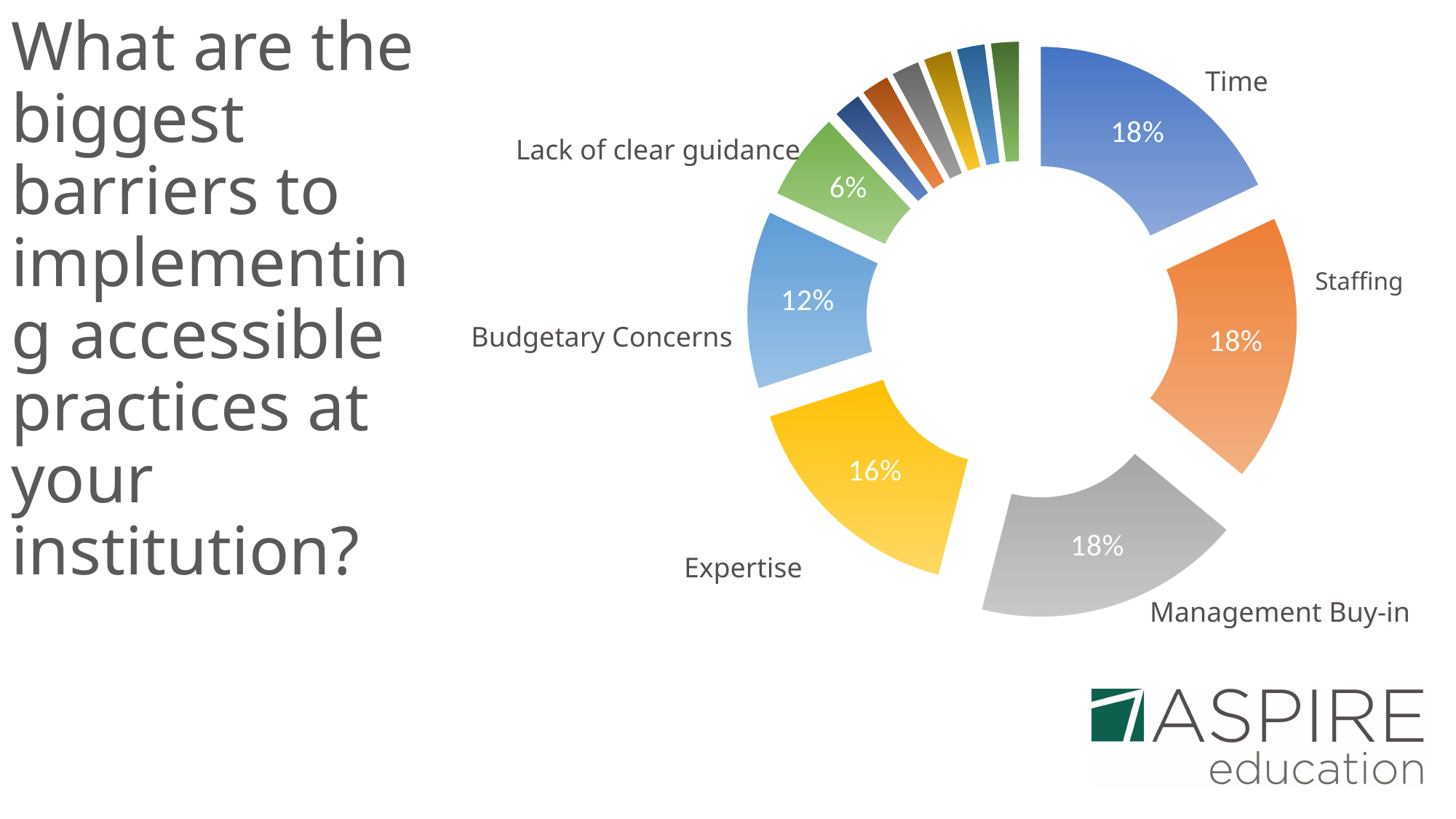
What percentage is shown for Time? 18% What kind of chart is shown on the slide? Doughnut (pie) chart What is the difference in percentage points between Budgetary Concerns and Lack of clear guidance? 6 What percentage is shown for Staffing? 18% Which is larger, the share for Expertise or the share for Budgetary Concerns? Expertise What percentage is shown for Lack of clear guidance? 6% What percentage is shown for Management Buy-in? 18% What percentage is shown for Expertise? 16% Among the labelled categories, which has the smallest share? Lack of clear guidance What percentage is shown for Budgetary Concerns? 12% What question does the slide title ask? What are the biggest barriers to implementing accessible practices at your institution? What is the difference in percentage points between Time and Expertise? 2